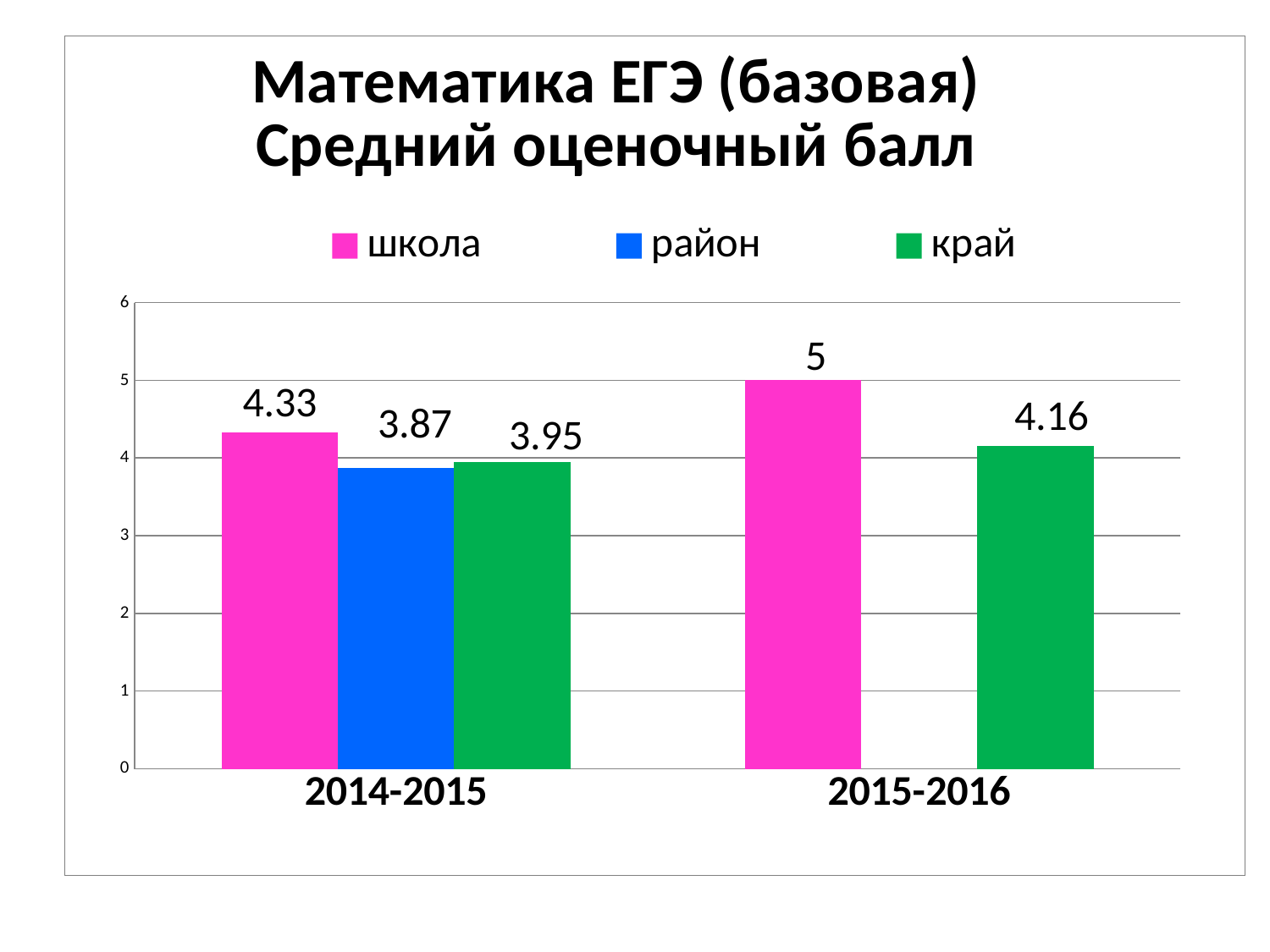
What is the difference between the школа values for 2015-2016 and 2014-2015? 0.67 How many series does the legend list? 3 Which series has the lowest value in 2014-2015? район What kind of chart is shown on the slide? bar chart What is the value for район in 2014-2015? 3.87 Does the value for край rise or fall from 2014-2015 to 2015-2016? rise What is the value for школа in 2014-2015? 4.33 How many categories are shown on the x axis? 2 Which is larger in 2014-2015: the value for школа or the value for край? школа Which series has the highest value in 2015-2016? школа What is the value for край in 2015-2016? 4.16 What is the value for школа in 2015-2016? 5